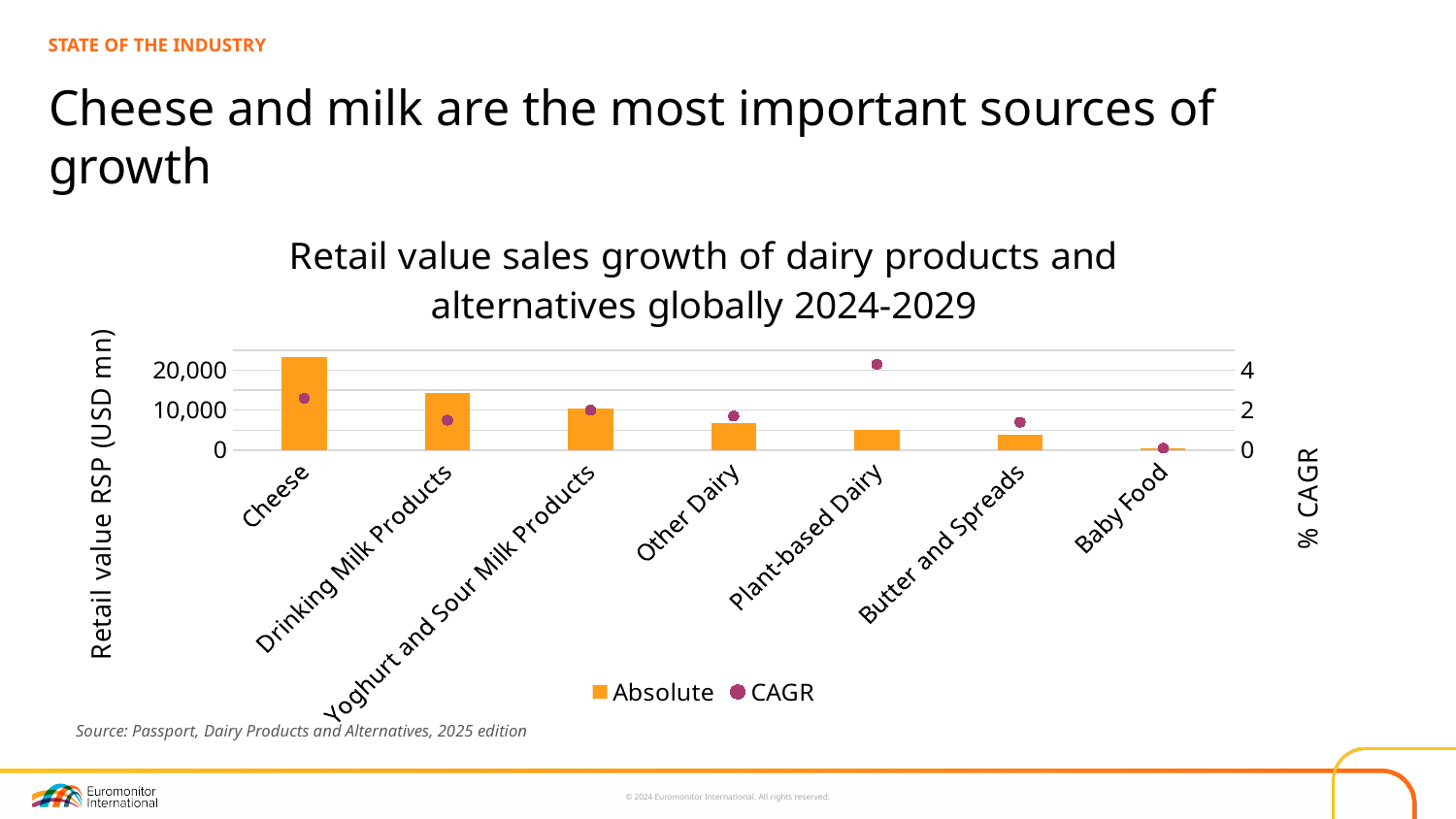
Which category has the highest Absolute retail value sales growth? Cheese What is the label of the left vertical axis? Retail value RSP (USD mn) Is the CAGR for Plant-based Dairy greater or less than 2? greater Is the Absolute value for Cheese greater or less than 20,000? greater Which category has the highest CAGR? Plant-based Dairy What kind of chart is used to plot the Absolute series? bar chart Which has the larger Absolute value, Drinking Milk Products or Butter and Spreads? Drinking Milk Products How many product categories are shown on the x axis? 7 Is the Absolute value for Other Dairy greater or less than 10,000? less How many series does the legend list? 2 Do the Absolute bars rise or fall moving from left to right along the x axis? fall Which category has the lowest Absolute retail value sales growth? Baby Food